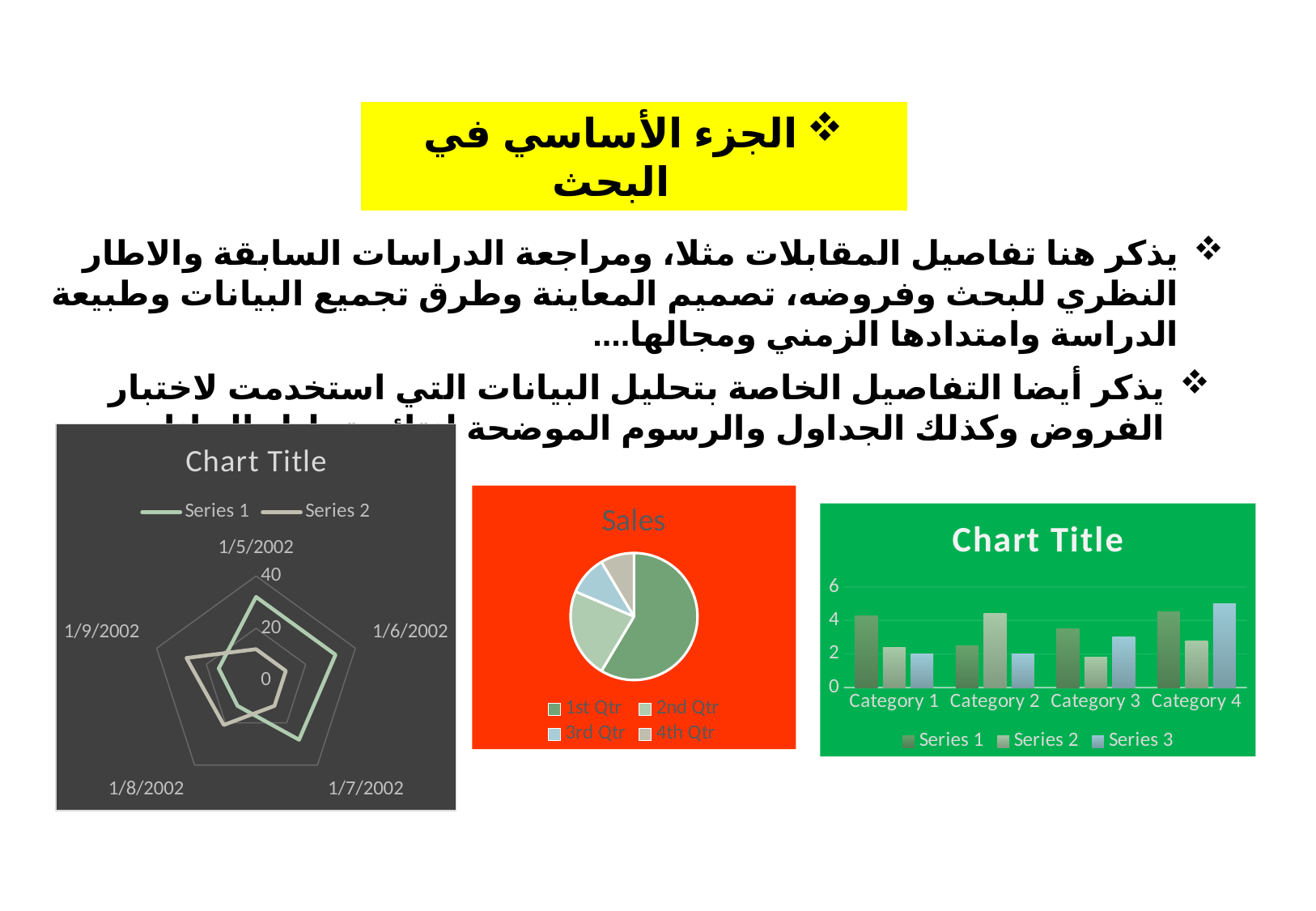
How many series does the legend of the right bar chart list? 3 In the right bar chart, which is larger for Category 2: Series 2 or Series 3? Series 2 In the Sales pie chart, which quarter has the largest slice? 1st Qtr How many series does the legend of the left radar chart list? 2 On the left radar chart, is the value of Series 1 at 1/5/2002 greater or less than 20? greater How many slices does the Sales pie chart have? 4 How many date categories are plotted on the left radar chart? 5 What is the title of the pie chart in the middle of the slide? Sales In the right bar chart, is the value of Series 3 for Category 4 greater or less than 4? greater In the right bar chart, which series has the highest value for Category 4? Series 3 What kind of chart is the chart on the left of the slide (dark background)? radar chart What kind of chart is the chart on the right of the slide (green background)? bar chart